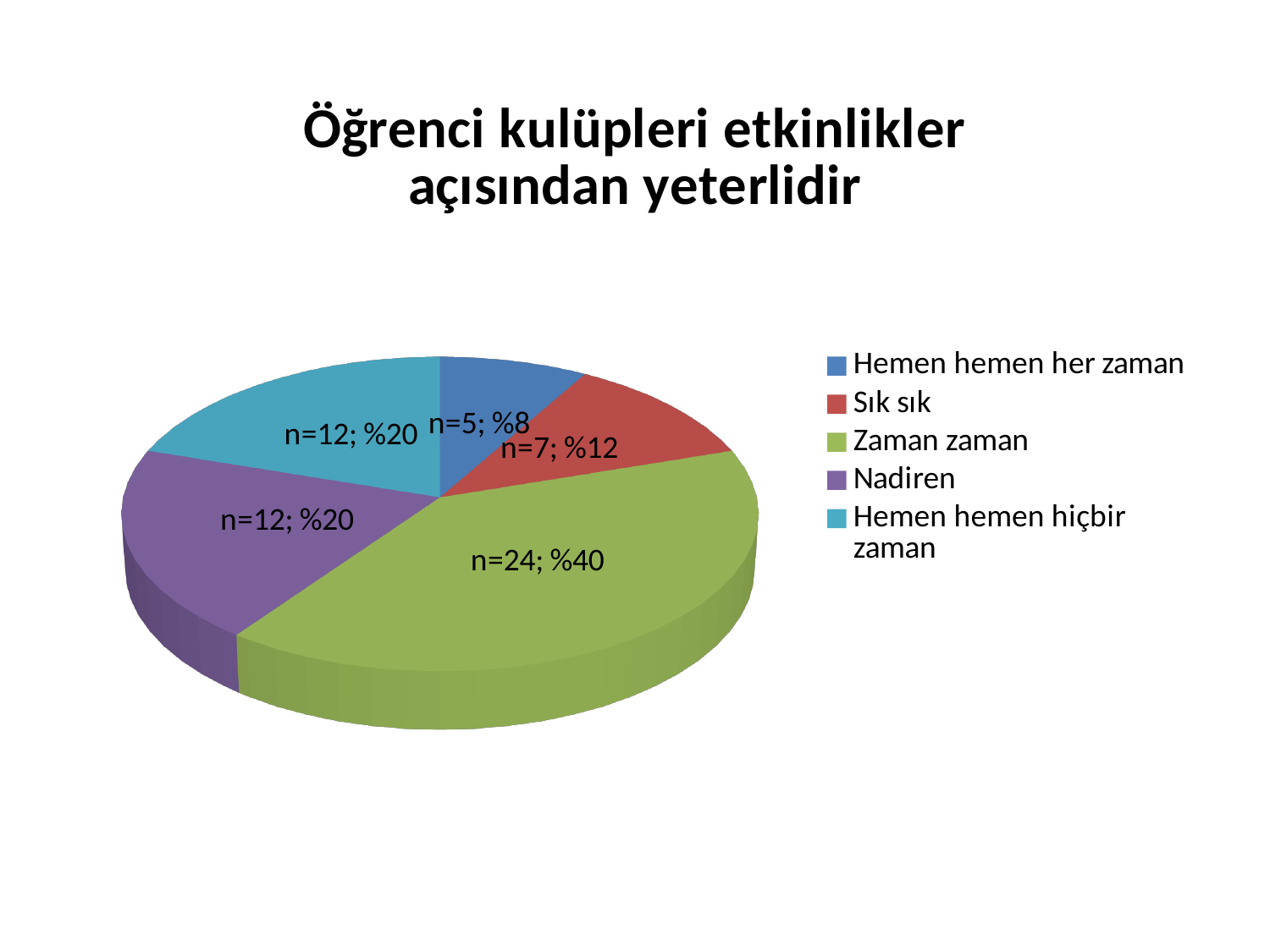
What kind of chart is shown on the slide? pie chart How many categories does the legend list? 5 Which category has the smallest slice? Hemen hemen her zaman What is the difference in n between 'Zaman zaman' and 'Nadiren'? 12 What is the value shown for the 'Hemen hemen her zaman' slice? n=5; %8 What is the value shown for the 'Zaman zaman' slice? n=24; %40 What colour is the 'Hemen hemen hiçbir zaman' slice? teal (light blue) What is the value shown for the 'Sık sık' slice? n=7; %12 Which category has the largest slice? Zaman zaman What is the title of the chart? Öğrenci kulüpleri etkinlikler açısından yeterlidir What percentage share does the 'Nadiren' slice have? %20 Which is larger, the 'Sık sık' slice or the 'Hemen hemen her zaman' slice? Sık sık